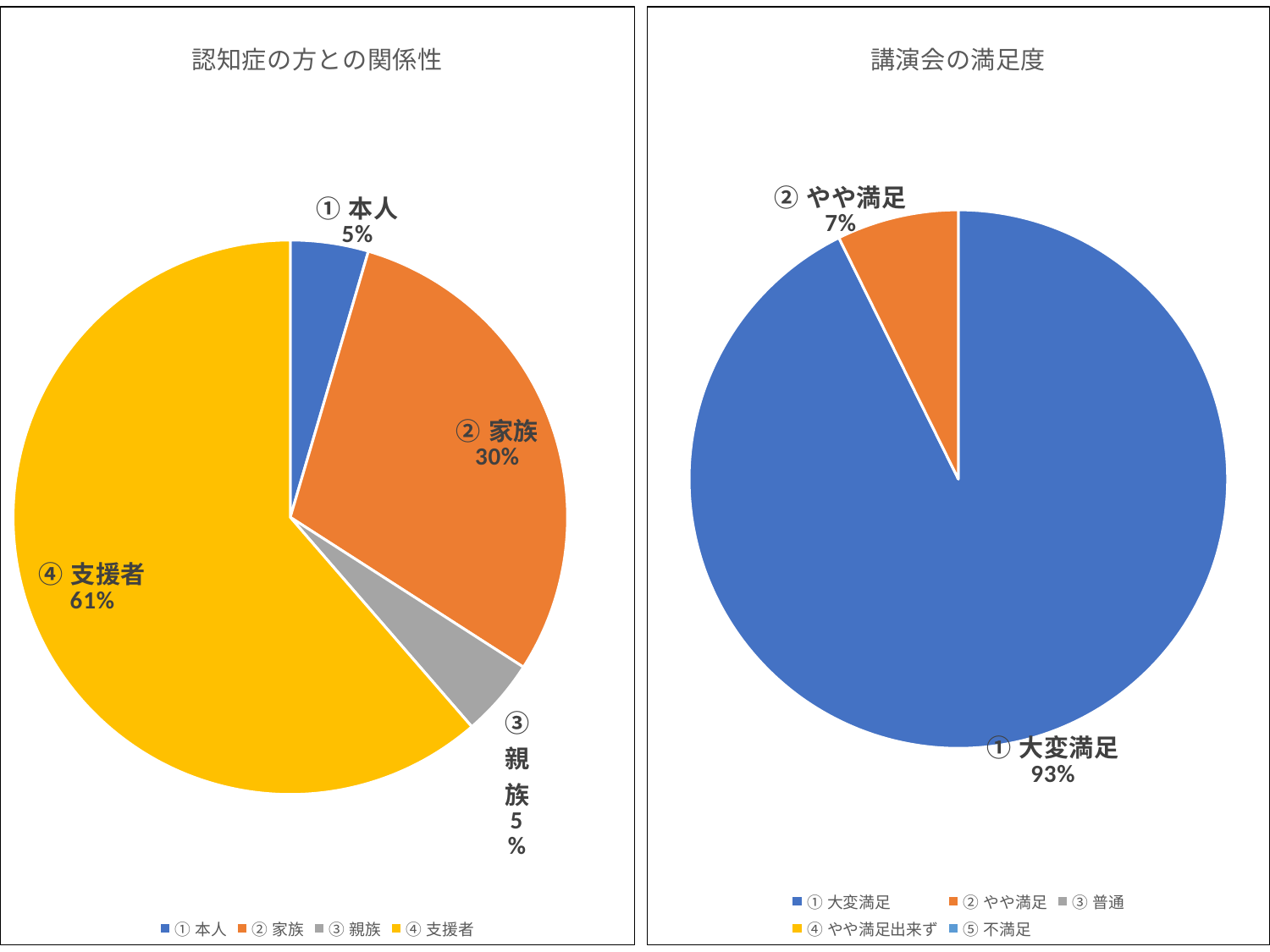
In the chart titled 講演会の満足度, what is the difference in percentage points between ① 大変満足 and ② やや満足? 86 In the chart titled 認知症の方との関係性, what is the difference in percentage points between ④ 支援者 and ② 家族? 31 In the chart titled 講演会の満足度, what percentage is shown for ① 大変満足? 93% In the chart titled 講演会の満足度, what colour is the slice for ① 大変満足? Blue In the chart titled 講演会の満足度, how many categories does the legend list? 5 In the chart titled 認知症の方との関係性, how many categories does the legend list? 4 In the chart titled 認知症の方との関係性, what percentage is shown for ② 家族? 30% In the chart titled 講演会の満足度, what percentage is shown for ② やや満足? 7% In the chart titled 認知症の方との関係性, which is larger, ② 家族 or ① 本人? ② 家族 What kind of chart is the chart titled 講演会の満足度? Pie chart In the chart titled 認知症の方との関係性, which category has the largest share? ④ 支援者 In the chart titled 認知症の方との関係性, what percentage is shown for ④ 支援者? 61%